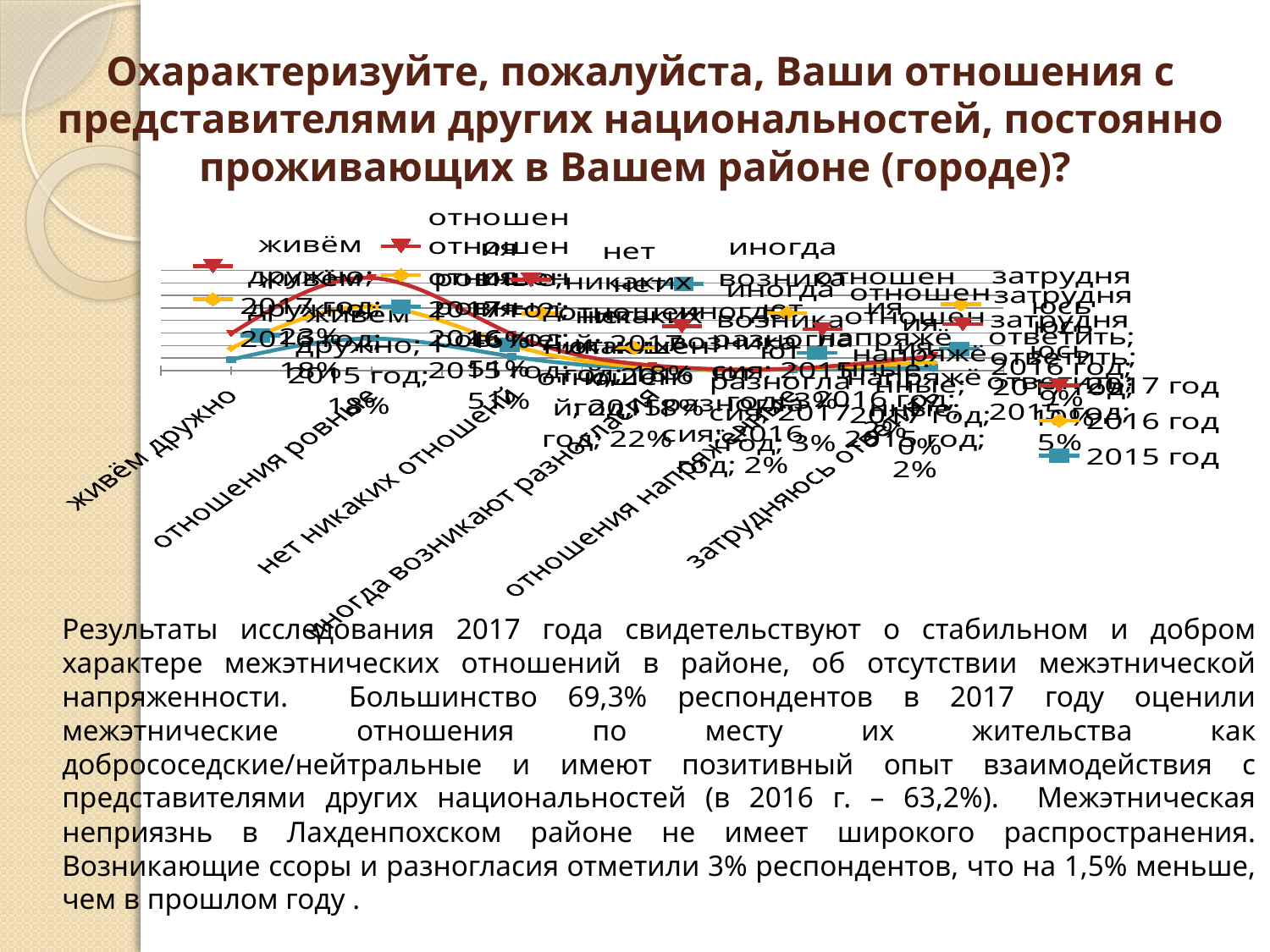
In the 2015 год series, which is larger: 'живём дружно' or 'отношения ровные'? отношения ровные How many categories are shown along the x axis of the chart? 6 How many series does the chart legend list? 3 Which category has the highest values for all three series in the chart? отношения ровные What is the value for 'отношения ровные' in the 2015 год series? 51% What kind of chart is shown on the slide? line chart Do the values fall or rise along the x axis after the category 'отношения ровные'? fall What is the difference between 'отношения ровные' and 'живём дружно' in the 2015 год series? 33% What is the value for 'живём дружно' in the 2015 год series? 18% Which years are listed in the chart legend? 2017 год, 2016 год, 2015 год Which category is the first one on the x axis of the chart? живём дружно